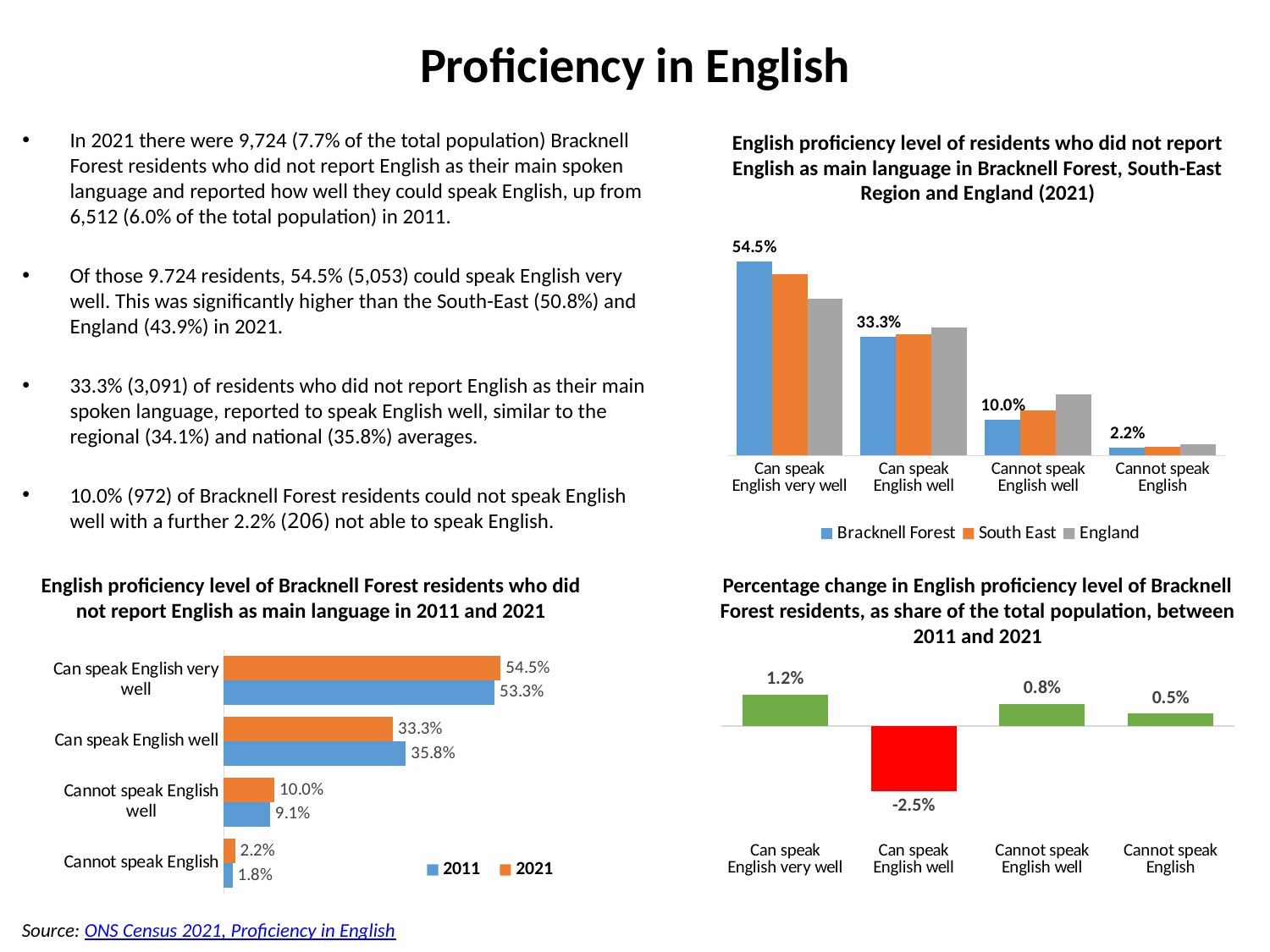
In the chart titled 'Percentage change in English proficiency level of Bracknell Forest residents, as share of the total population, between 2011 and 2021', which category has the highest value? Can speak English very well In the chart titled 'English proficiency level of residents who did not report English as main language in Bracknell Forest, South-East Region and England (2021)', what is the Bracknell Forest value for 'Cannot speak English well'? 10.0% In the chart titled 'English proficiency level of Bracknell Forest residents who did not report English as main language in 2011 and 2021', how many series does the legend list? 2 In the chart titled 'English proficiency level of Bracknell Forest residents who did not report English as main language in 2011 and 2021', which is larger for 'Can speak English well': the 2011 value or the 2021 value? 2011 In the chart titled 'English proficiency level of Bracknell Forest residents who did not report English as main language in 2011 and 2021', which category has the lowest 2021 value? Cannot speak English In the chart titled 'English proficiency level of residents who did not report English as main language in Bracknell Forest, South-East Region and England (2021)', which series has the highest bar for 'Can speak English very well'? Bracknell Forest In the chart titled 'Percentage change in English proficiency level of Bracknell Forest residents, as share of the total population, between 2011 and 2021', how many categories are shown? 4 In the chart titled 'English proficiency level of Bracknell Forest residents who did not report English as main language in 2011 and 2021', what is the difference between the 2021 and 2011 values for 'Can speak English very well'? 1.2% In the chart titled 'English proficiency level of Bracknell Forest residents who did not report English as main language in 2011 and 2021', what is the 2011 value for 'Cannot speak English well'? 9.1% In the chart titled 'English proficiency level of residents who did not report English as main language in Bracknell Forest, South-East Region and England (2021)', how many series does the legend list? 3 In the chart titled 'Percentage change in English proficiency level of Bracknell Forest residents, as share of the total population, between 2011 and 2021', what is the value for 'Can speak English well'? -2.5% In the chart titled 'English proficiency level of Bracknell Forest residents who did not report English as main language in 2011 and 2021', what is the 2021 value for 'Can speak English well'? 33.3%